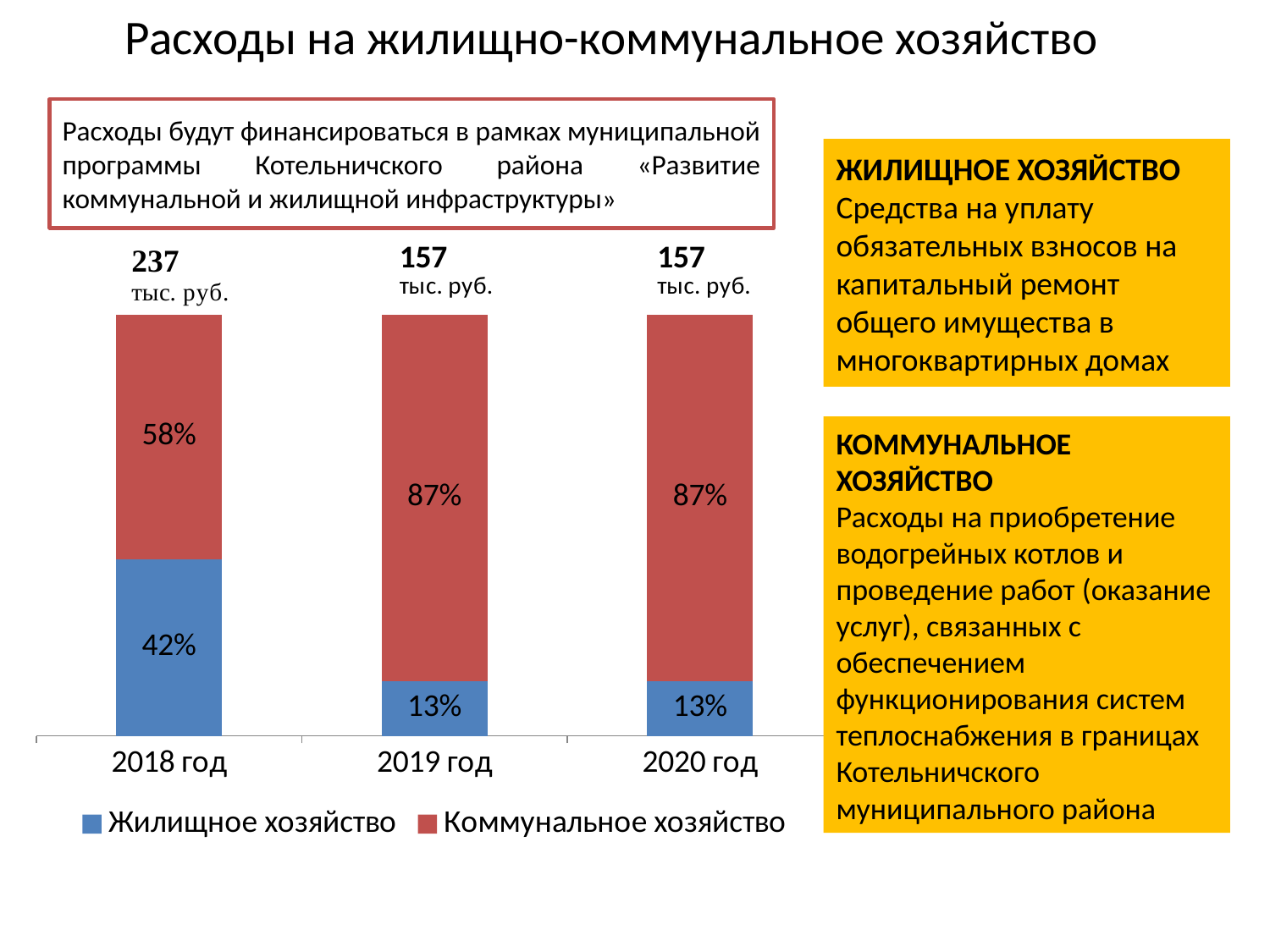
What total amount is printed above the 2020 год bar? 157 тыс. руб. How many years (categories) are shown on the x axis of the chart? 3 In which year is the share of Жилищное хозяйство the highest? 2018 год What share of the 2018 год bar is Жилищное хозяйство? 42% Which is larger in 2019 год: the share of Жилищное хозяйство or Коммунальное хозяйство? Коммунальное хозяйство What share of the 2020 год bar is Жилищное хозяйство? 13% What share of the 2019 год bar is Коммунальное хозяйство? 87% How many series does the chart legend list? 2 What type of chart is shown on the slide? stacked bar chart What is the difference between the Коммунальное хозяйство share in 2019 год and in 2018 год? 29% What total amount is printed above the 2018 год bar? 237 тыс. руб. What share of the 2018 год bar is Коммунальное хозяйство? 58%